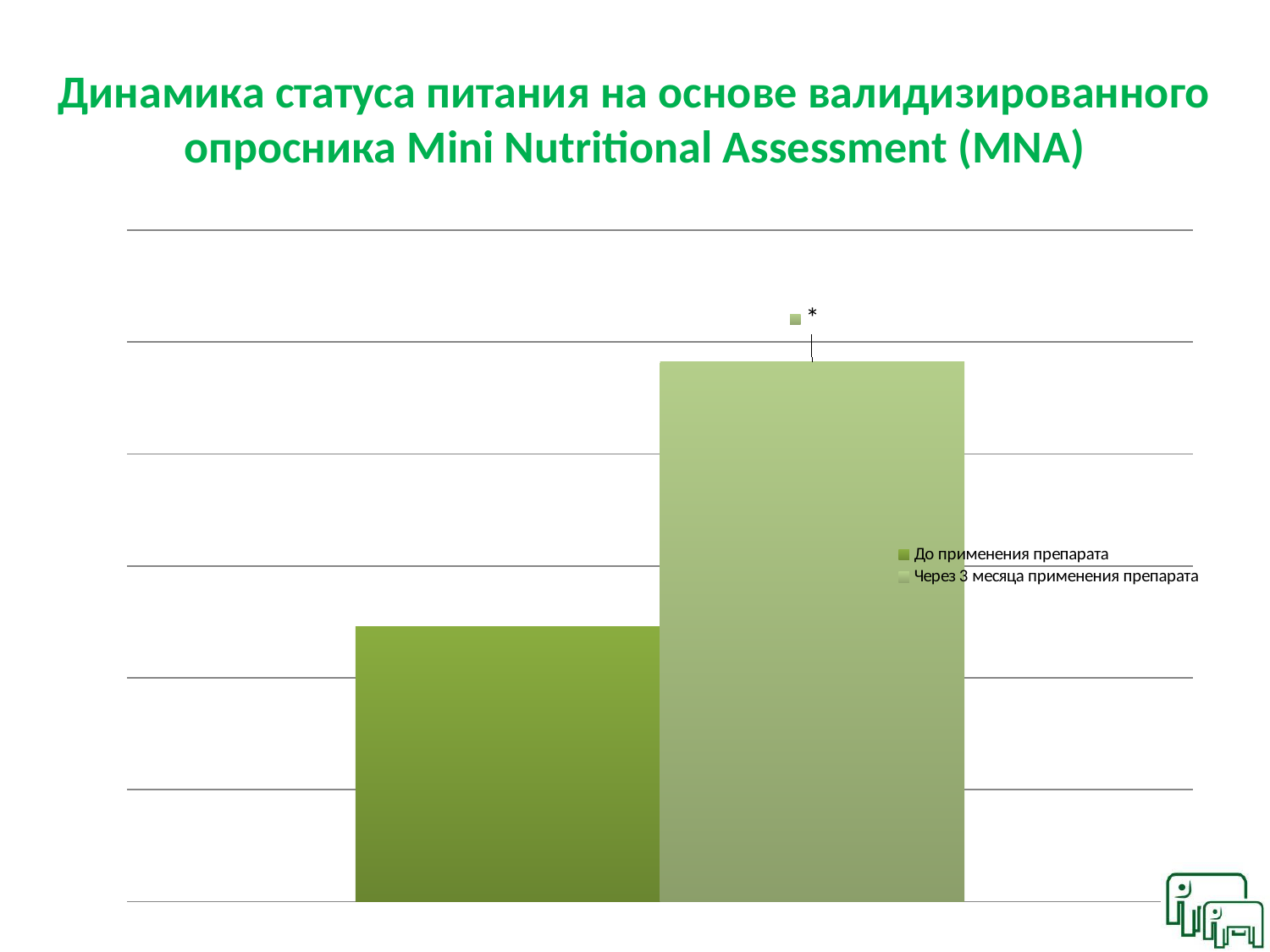
Does the bar value rise or fall from "До применения препарата" to "Через 3 месяца применения препарата"? Rise Which series has the taller bar: "До применения препарата" or "Через 3 месяца применения препарата"? Через 3 месяца применения препарата What is the first legend entry in the chart? До применения препарата Which series has the highest bar in the chart? Через 3 месяца применения препарата What is the title of the chart on the slide? Динамика статуса питания на основе валидизированного опросника Mini Nutritional Assessment (MNA) How many bars are plotted in the chart? 2 What kind of chart is shown on the slide? Bar chart How many series does the legend list? 2 Which series has the lowest bar in the chart? До применения препарата